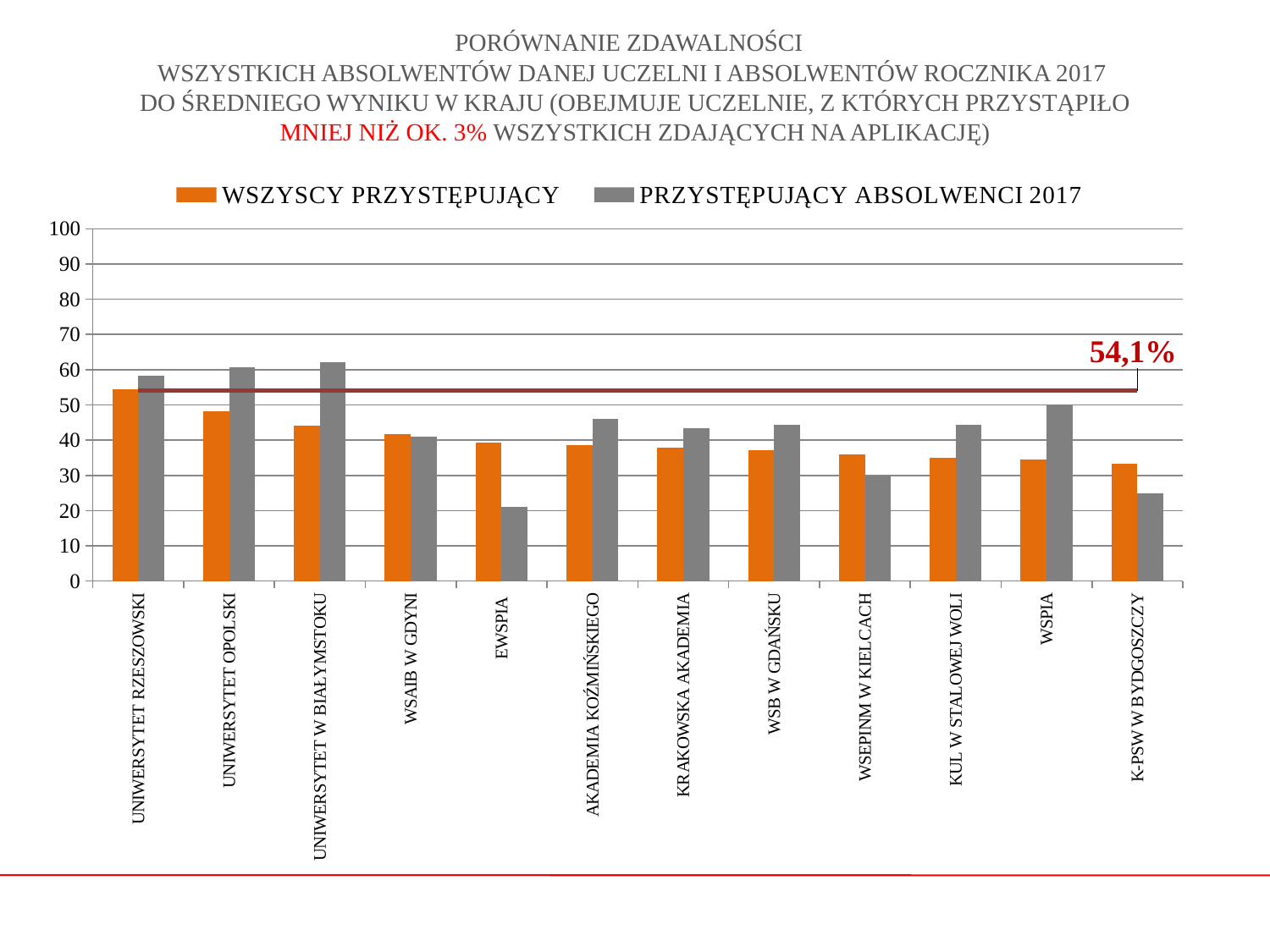
Which university has the lowest value for the PRZYSTĘPUJĄCY ABSOLWENCI 2017 series? EWSPIA For WSPIA, which series has the larger value: WSZYSCY PRZYSTĘPUJĄCY or PRZYSTĘPUJĄCY ABSOLWENCI 2017? PRZYSTĘPUJĄCY ABSOLWENCI 2017 What kind of chart is shown on the slide? bar chart Which university has the highest value for the WSZYSCY PRZYSTĘPUJĄCY series? UNIWERSYTET RZESZOWSKI Is the PRZYSTĘPUJĄCY ABSOLWENCI 2017 value for UNIWERSYTET W BIAŁYMSTOKU greater or less than 60? greater What value is labelled on the horizontal reference line drawn across the chart? 54,1% Which university has the lowest value for the WSZYSCY PRZYSTĘPUJĄCY series? K-PSW W BYDGOSZCZY Is the PRZYSTĘPUJĄCY ABSOLWENCI 2017 value for EWSPIA greater or less than 30? less For EWSPIA, which series has the larger value: WSZYSCY PRZYSTĘPUJĄCY or PRZYSTĘPUJĄCY ABSOLWENCI 2017? WSZYSCY PRZYSTĘPUJĄCY Do the WSZYSCY PRZYSTĘPUJĄCY values rise or fall from left to right along the x axis? fall How many series does the chart's legend list? 2 How many universities are shown on the x axis of the chart? 12